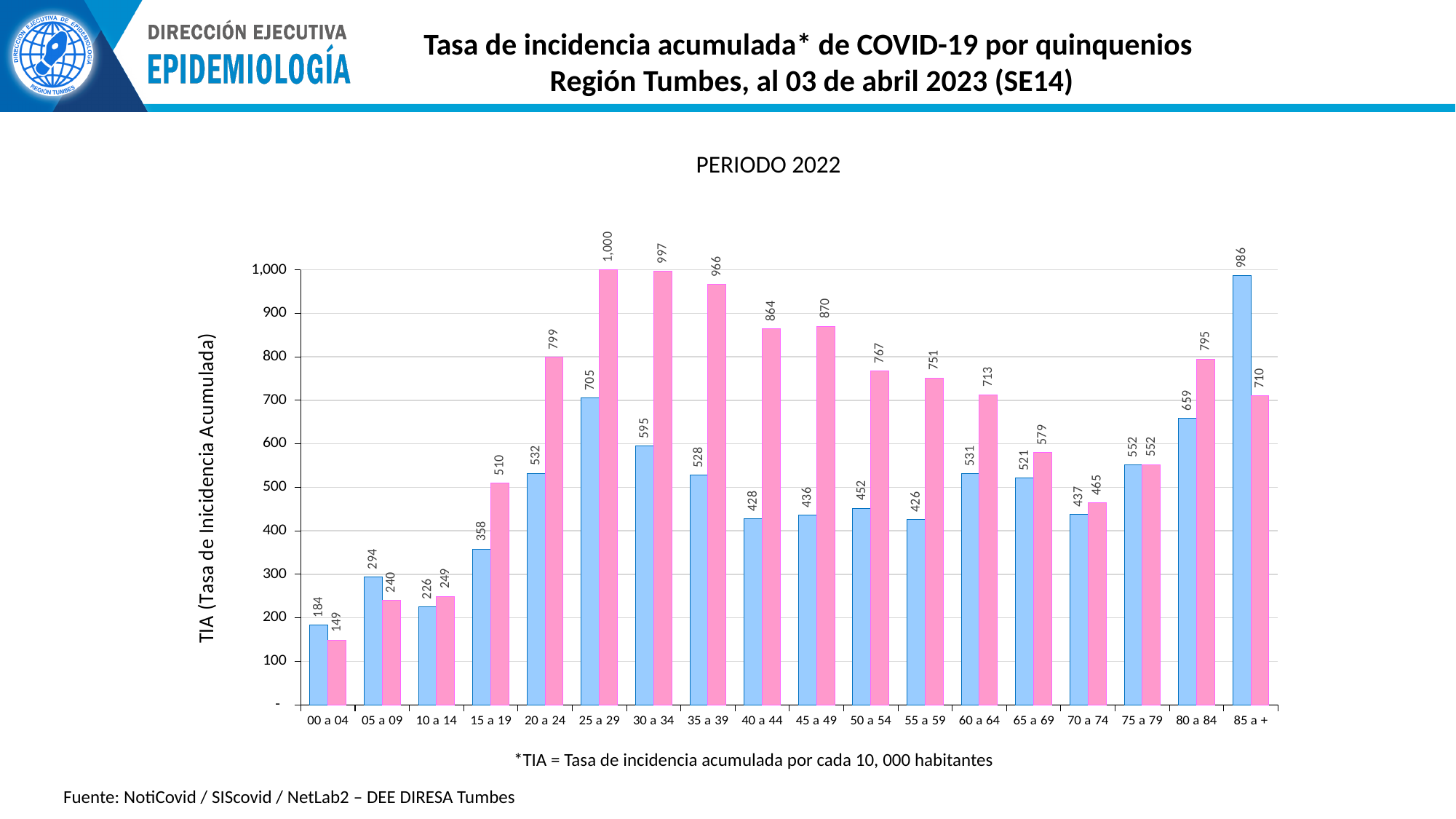
What is the value of the blue bar for the 75 a 79 age group? 552 What is the difference between the blue bar and the pink bar for the 85 a + age group? 276 Which age group has the lowest value among the pink bars? 00 a 04 Is the value of the blue bar for the 30 a 34 age group greater or less than 500? greater Which age group has the highest value among the blue bars? 85 a + For the 80 a 84 age group, which bar is larger, the blue or the pink? pink What kind of chart is shown on the slide? bar chart What is the value of the pink bar for the 45 a 49 age group? 870 What is the value of the blue bar for the 25 a 29 age group? 705 How many age groups are shown on the x axis? 18 What is the title shown above the chart? PERIODO 2022 What is the difference between the pink bar and the blue bar for the 20 a 24 age group? 267